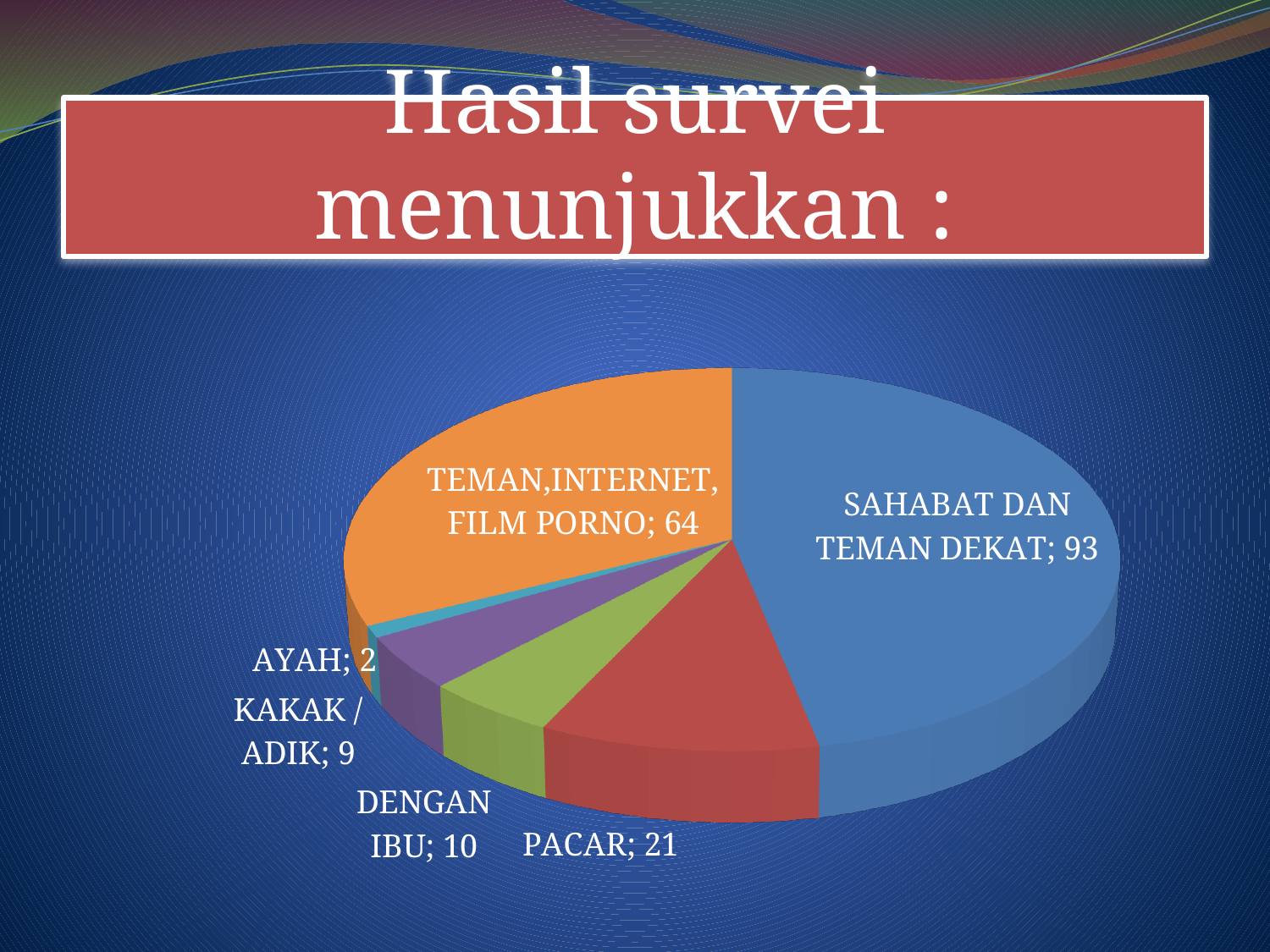
What is the difference between the values for SAHABAT DAN TEMAN DEKAT and TEMAN,INTERNET, FILM PORNO? 29 Which category has the largest slice in the pie chart? SAHABAT DAN TEMAN DEKAT What is the value for SAHABAT DAN TEMAN DEKAT in the pie chart? 93 Which category has the smallest slice in the pie chart? AYAH What is the total of all the values shown in the pie chart? 199 What kind of chart is shown on the slide? Pie chart What is the value for AYAH in the pie chart? 2 Which is larger, the value for DENGAN IBU or the value for KAKAK / ADIK? DENGAN IBU What is the value for TEMAN,INTERNET, FILM PORNO in the pie chart? 64 How many categories are shown in the pie chart? 6 What is the title of the slide containing the pie chart? Hasil survei menunjukkan : What is the value for PACAR in the pie chart? 21